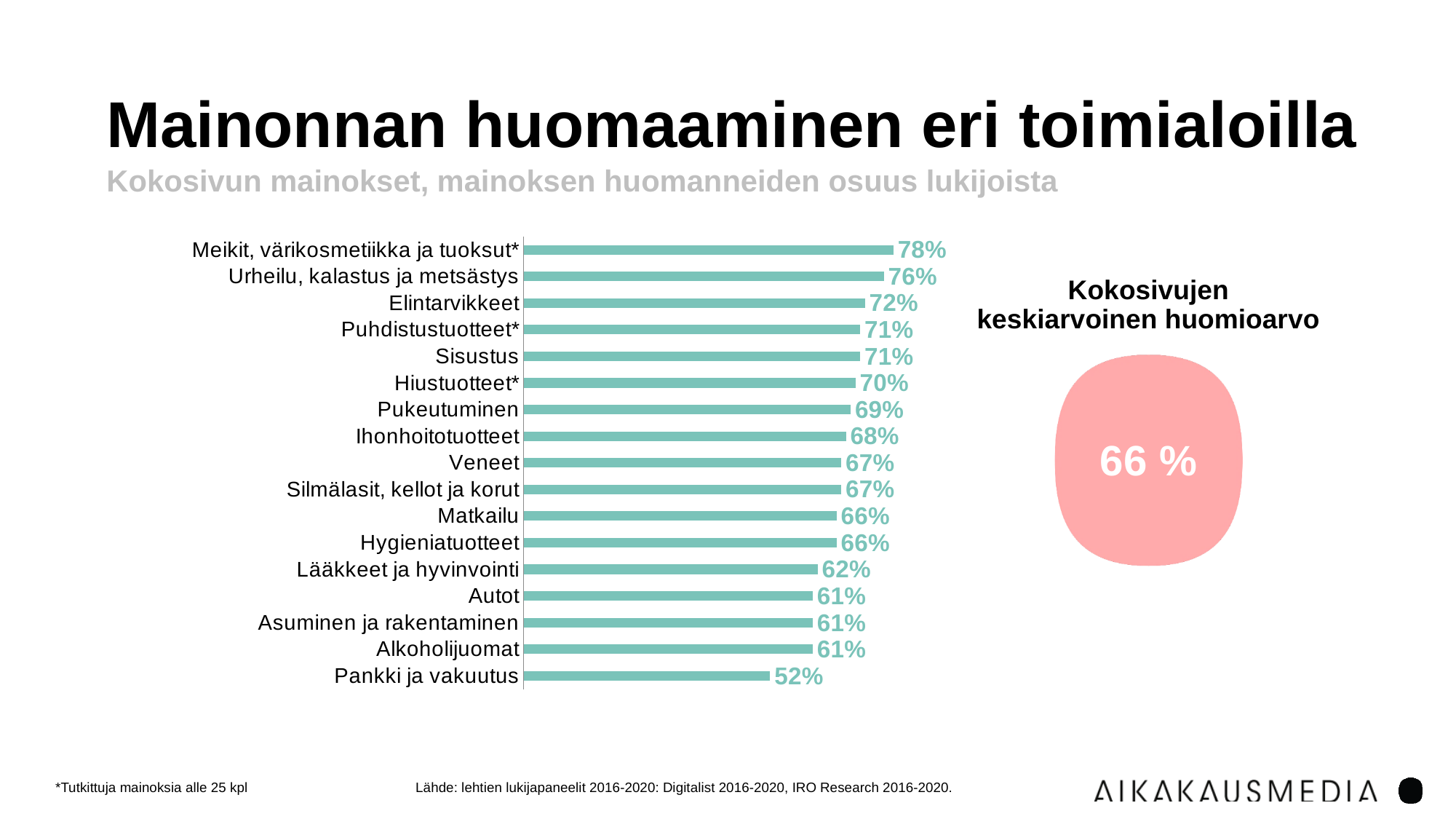
What is the title of the slide? Mainonnan huomaaminen eri toimialoilla What kind of chart is shown on the slide? Bar chart What is the value for Elintarvikkeet? 72% What is the value for Pankki ja vakuutus? 52% Which category has the lowest value? Pankki ja vakuutus What is the value for Lääkkeet ja hyvinvointi? 62% What is the difference between the values for Urheilu, kalastus ja metsästys and Autot? 15% How many categories are shown in the bar chart? 17 What is the difference between the values for Meikit, värikosmetiikka ja tuoksut* and Pankki ja vakuutus? 26% Which category has the highest value? Meikit, värikosmetiikka ja tuoksut* What is the average attention value (keskiarvoinen huomioarvo) shown in the circle on the right? 66 % Which is larger, the value for Pukeutuminen or the value for Matkailu? Pukeutuminen